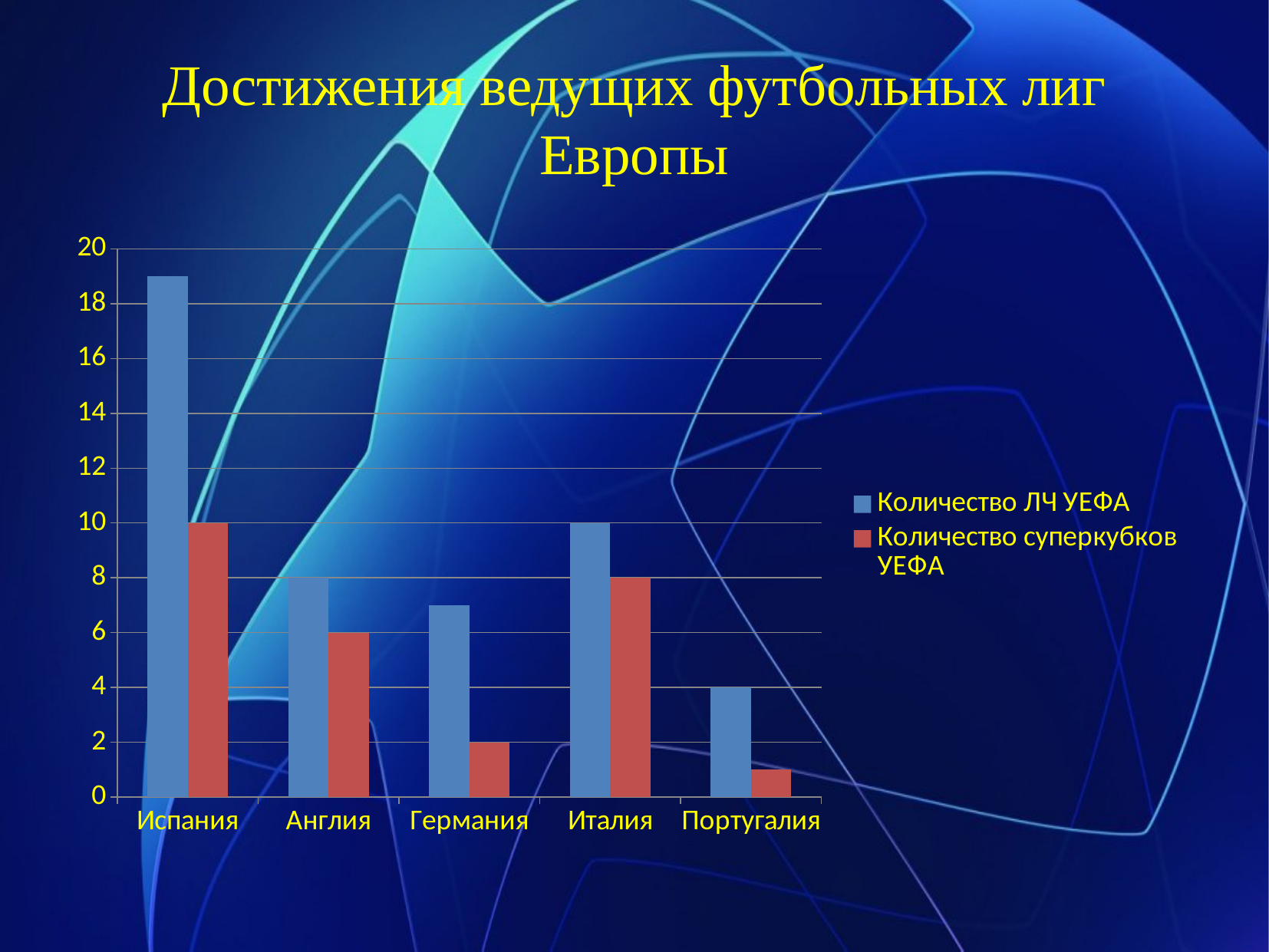
What is the value of Количество ЛЧ УЕФА for Италия? 10 What is the value of Количество суперкубков УЕФА for Германия? 2 Which country has the highest value for Количество ЛЧ УЕФА? Испания What is the value of Количество суперкубков УЕФА for Испания? 10 How many countries are shown on the x axis of the chart? 5 What is the value of Количество ЛЧ УЕФА for Англия? 8 Which country has the lowest value for Количество суперкубков УЕФА? Португалия What is the difference between Количество ЛЧ УЕФА and Количество суперкубков УЕФА for Италия? 2 How many series does the chart legend list? 2 Which is larger for Германия: Количество ЛЧ УЕФА or Количество суперкубков УЕФА? Количество ЛЧ УЕФА Is the value of Количество ЛЧ УЕФА for Испания greater or less than 18? greater What kind of chart is shown on the slide? Bar chart